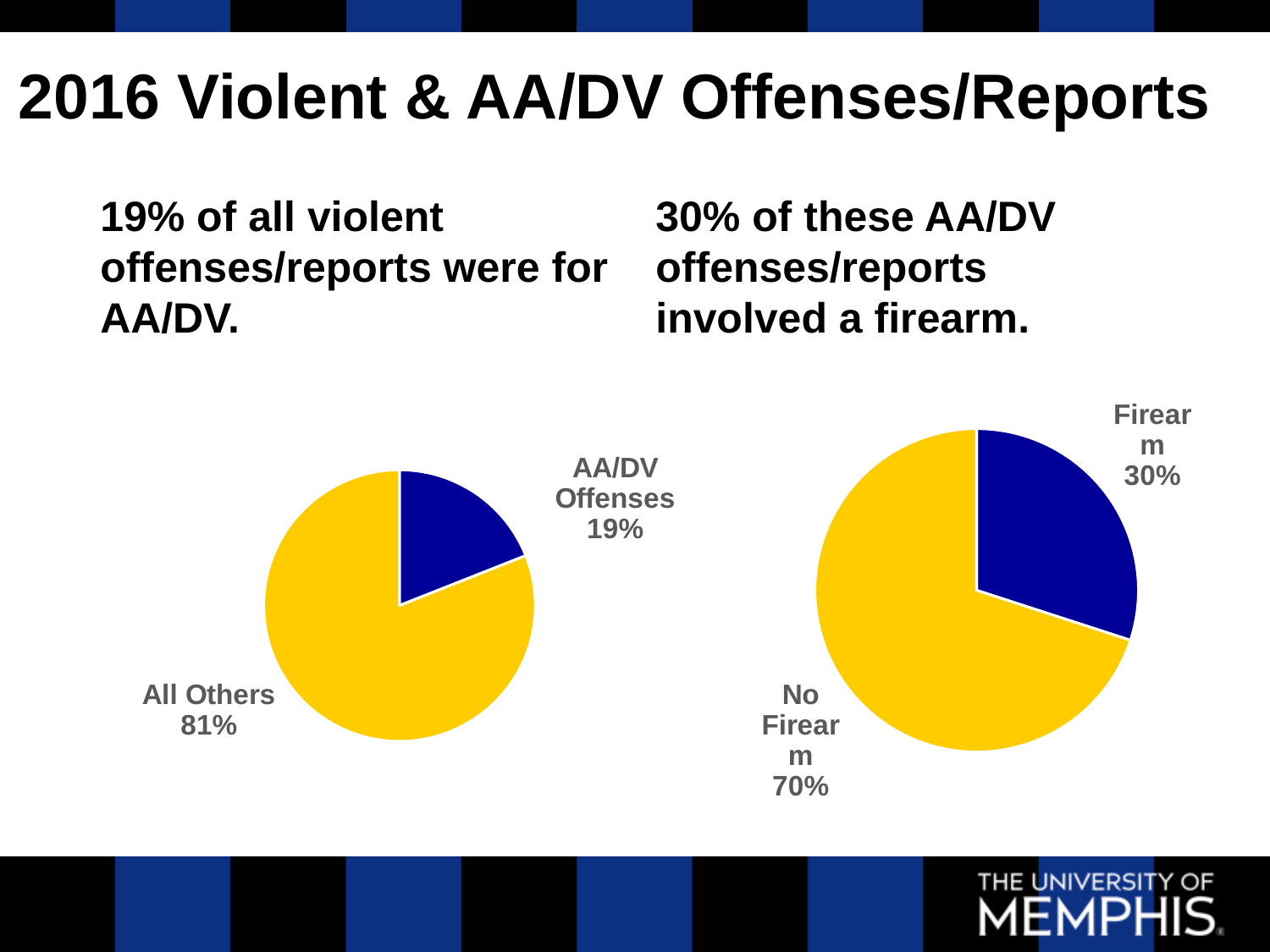
Which is larger: the Firearm share in the right pie chart or the AA/DV Offenses share in the left pie chart? Firearm In the right pie chart, which slice is the smallest? Firearm In the right pie chart, what share of AA/DV offenses/reports involved a firearm? 30% In the right pie chart, what is the difference in percentage points between No Firearm and Firearm? 40 In the left pie chart, what is the difference in percentage points between All Others and AA/DV Offenses? 62 In the left pie chart, what share of violent offenses/reports is labelled AA/DV Offenses? 19% In the left pie chart, what share is labelled All Others? 81% What type of chart is the left chart on the slide? Pie chart How many slices does the right pie chart have? 2 In the left pie chart, which slice is the largest? All Others In the left pie chart, what colour is the AA/DV Offenses slice? Blue